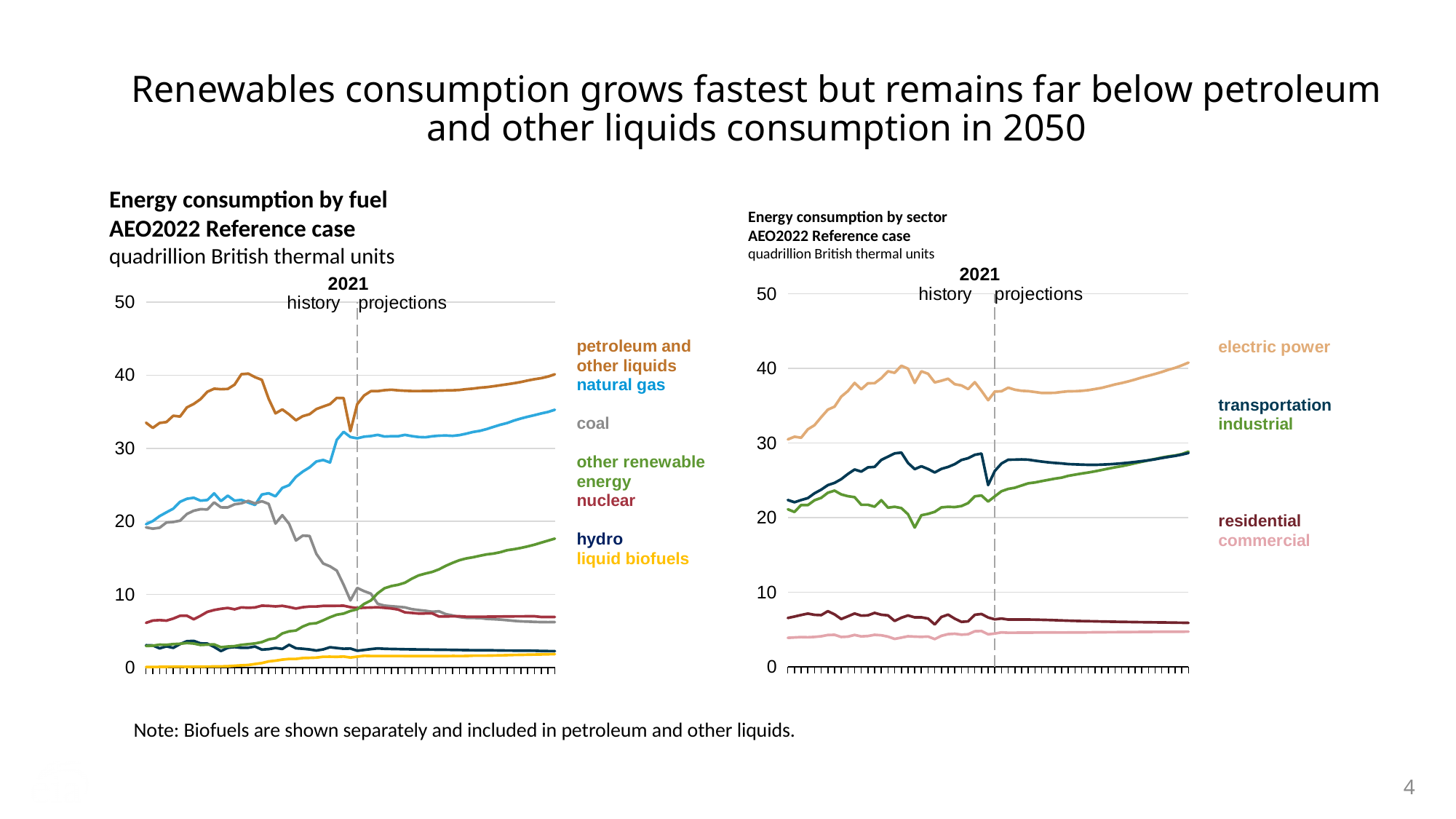
In the 'Energy consumption by fuel' chart, is the value for natural gas at the end of the projections greater or less than 30? greater In the 'Energy consumption by sector' chart, which sector has the lowest consumption at the end of the projection period? commercial In the 'Energy consumption by fuel' chart, does other renewable energy consumption rise or fall over the projection period? rise In the 'Energy consumption by fuel' chart, does coal consumption rise or fall over the period shown? fall In the 'Energy consumption by sector' chart, which sector has the highest consumption at the end of the projection period? electric power What kind of chart is the 'Energy consumption by fuel' chart? line chart In the 'Energy consumption by sector' chart, is the value for residential at the end of the projections greater or less than 10? less In the 'Energy consumption by fuel' chart, is the value for coal at the end of the projections greater or less than 10? less How many series does the legend of the 'Energy consumption by fuel' chart list? 7 In the 'Energy consumption by fuel' chart, which fuel has the highest consumption at the end of the projection period? petroleum and other liquids In the 'Energy consumption by fuel' chart, which fuel has the lowest consumption at the end of the projection period? liquid biofuels How many series does the legend of the 'Energy consumption by sector' chart list? 5